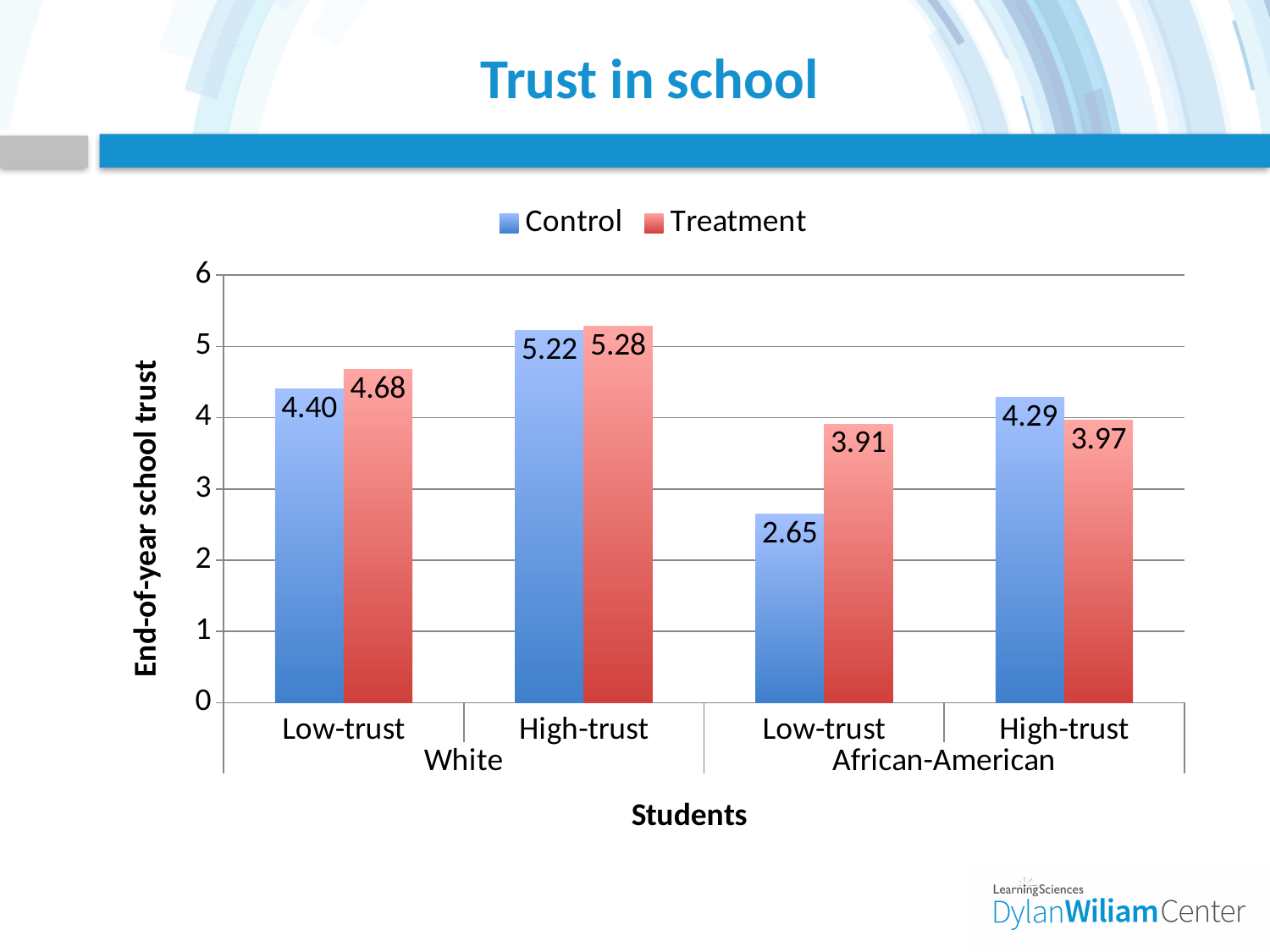
What is the Control value for Low-trust White students? 4.40 What is the Treatment value for High-trust White students? 5.28 What is the label of the y axis? End-of-year school trust Which group has the lowest Control value? Low-trust African-American How many series does the legend list? 2 Which group has the highest Treatment value? High-trust White What kind of chart is shown on the slide? Bar chart What is the Control value for High-trust African-American students? 4.29 Which is larger for High-trust African-American students, the Control value or the Treatment value? Control What is the Treatment value for Low-trust African-American students? 3.91 What is the difference between the Treatment and Control values for Low-trust African-American students? 1.26 How many student groups are shown on the x axis? 4